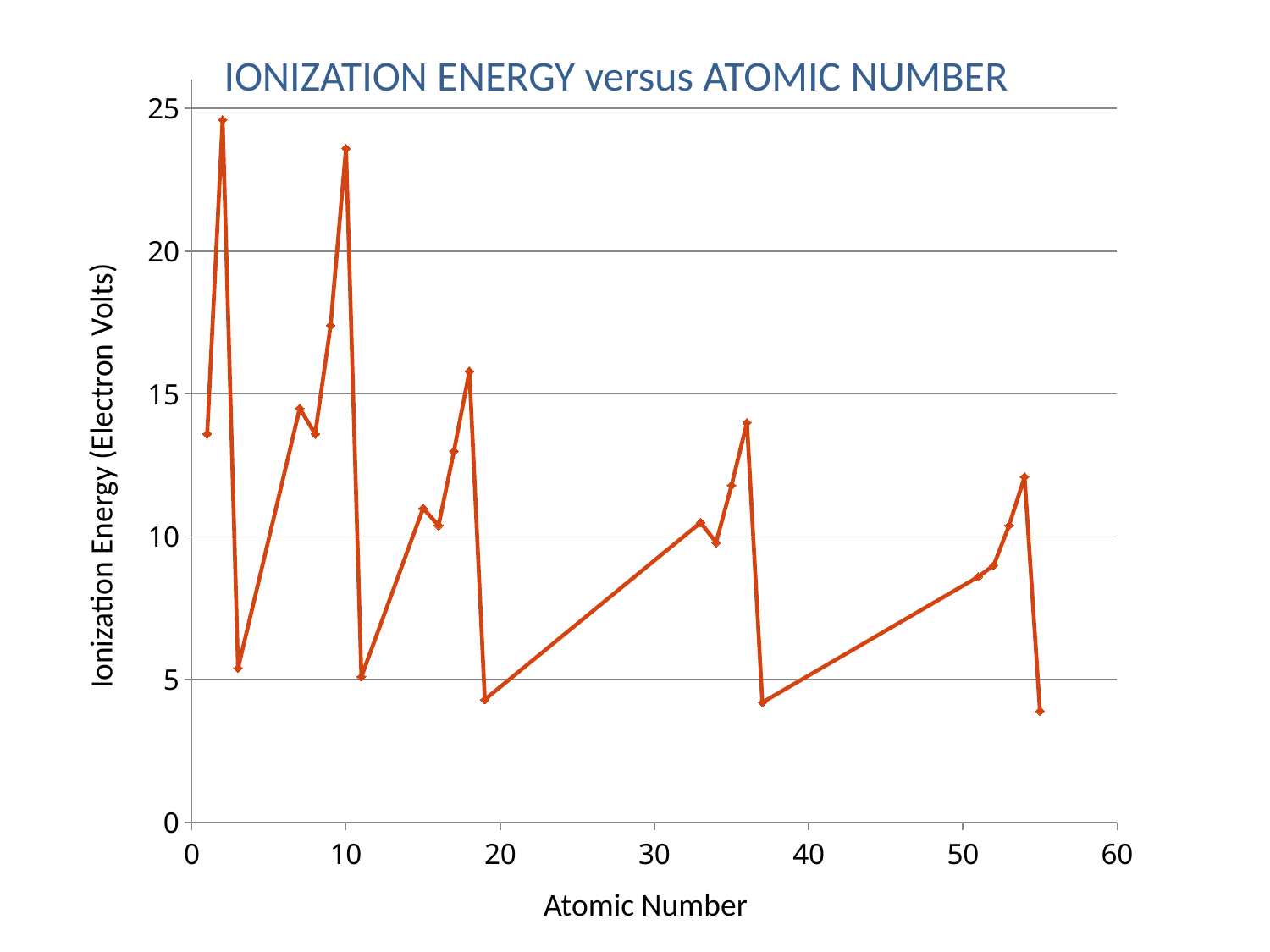
What kind of chart is shown on the slide? Line chart Is the ionization energy at atomic number 55 greater or less than 5? less What is the title of the chart? IONIZATION ENERGY versus ATOMIC NUMBER What is the label of the vertical axis? Ionization Energy (Electron Volts) Is the ionization energy at atomic number 2 greater or less than 20? greater Is the ionization energy at atomic number 36 greater or less than 10? greater Which has the higher ionization energy, atomic number 10 or atomic number 11? Atomic number 10 Does the ionization energy rise or fall between atomic number 37 and atomic number 54? Rise At which atomic number does the ionization energy reach its highest value? 2